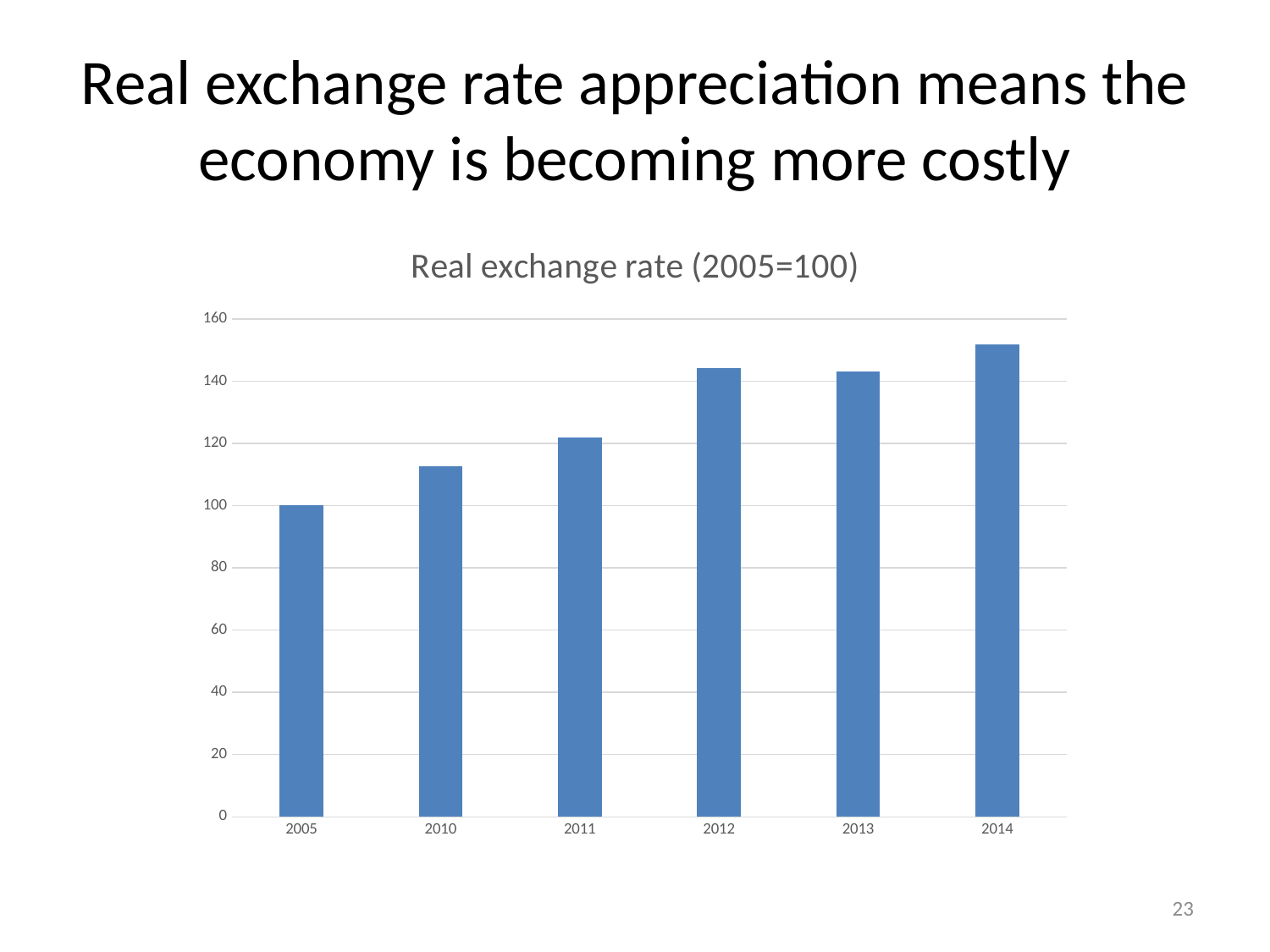
What kind of chart is shown on the slide? bar chart How many years are shown on the x axis of the chart? 6 Is the value for 2011 greater or less than 140? less Which is larger, the value for 2011 or the value for 2012? 2012 What is the title of the chart? Real exchange rate (2005=100) Do the values generally rise or fall from 2005 to 2014? rise Is the value for 2010 greater or less than 100? greater Which year has the highest real exchange rate? 2014 Is the value for 2010 greater or less than 120? less What is the value of the real exchange rate for 2005? 100 Which year has the lowest real exchange rate? 2005